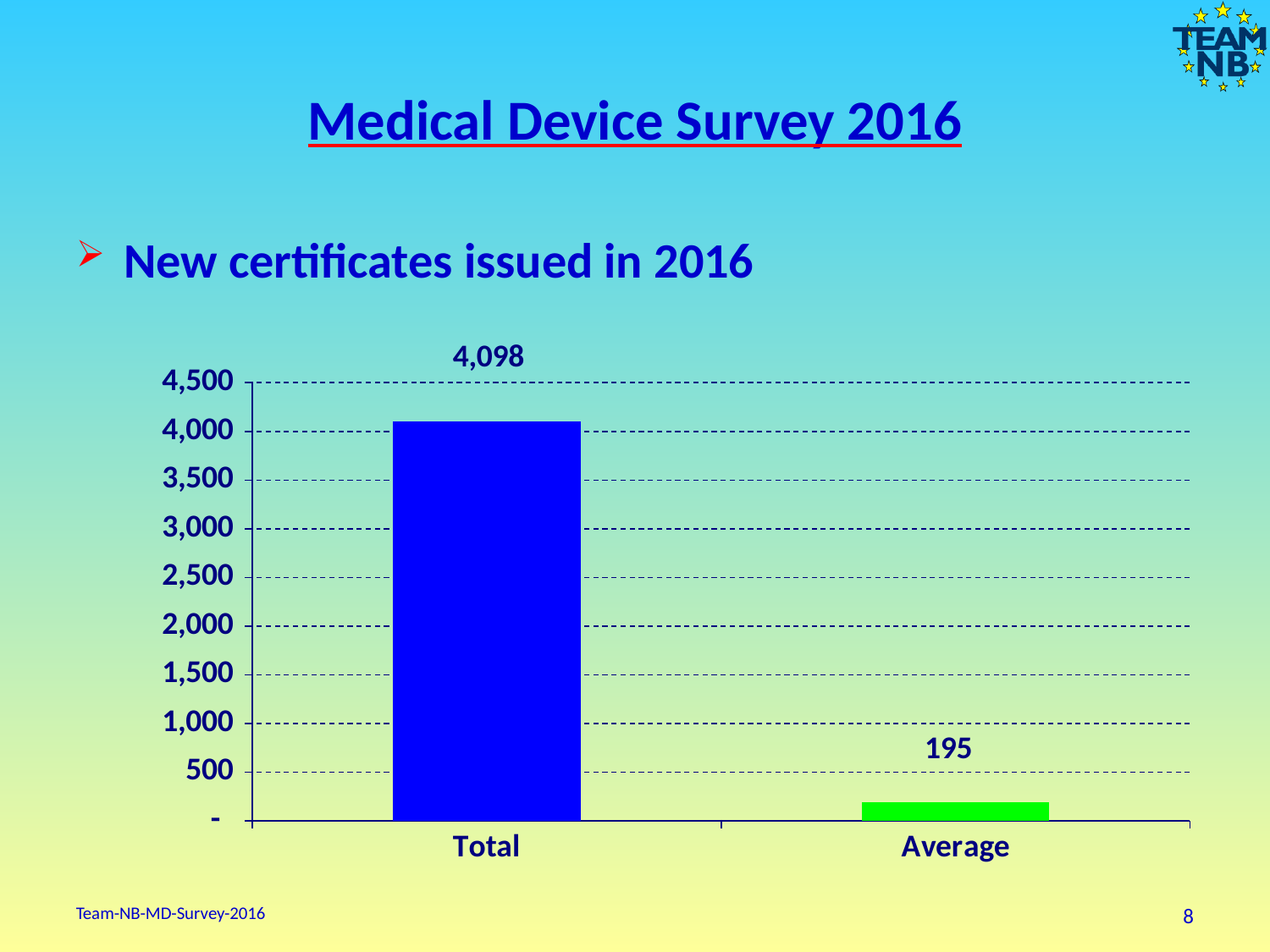
Is the value for Average greater or less than 500? less What is the difference between the Total and Average values? 3,903 What is the value of the Total bar? 4,098 What colour is the Average bar? green Which category has the highest value? Total Is the value for Total greater or less than 4,000? greater Which is larger, the value for Total or the value for Average? Total How many categories are shown on the x axis? 2 What kind of chart is shown on the slide? bar chart Which category has the lowest value? Average What is the highest value shown on the y axis? 4,500 What is the value of the Average bar? 195